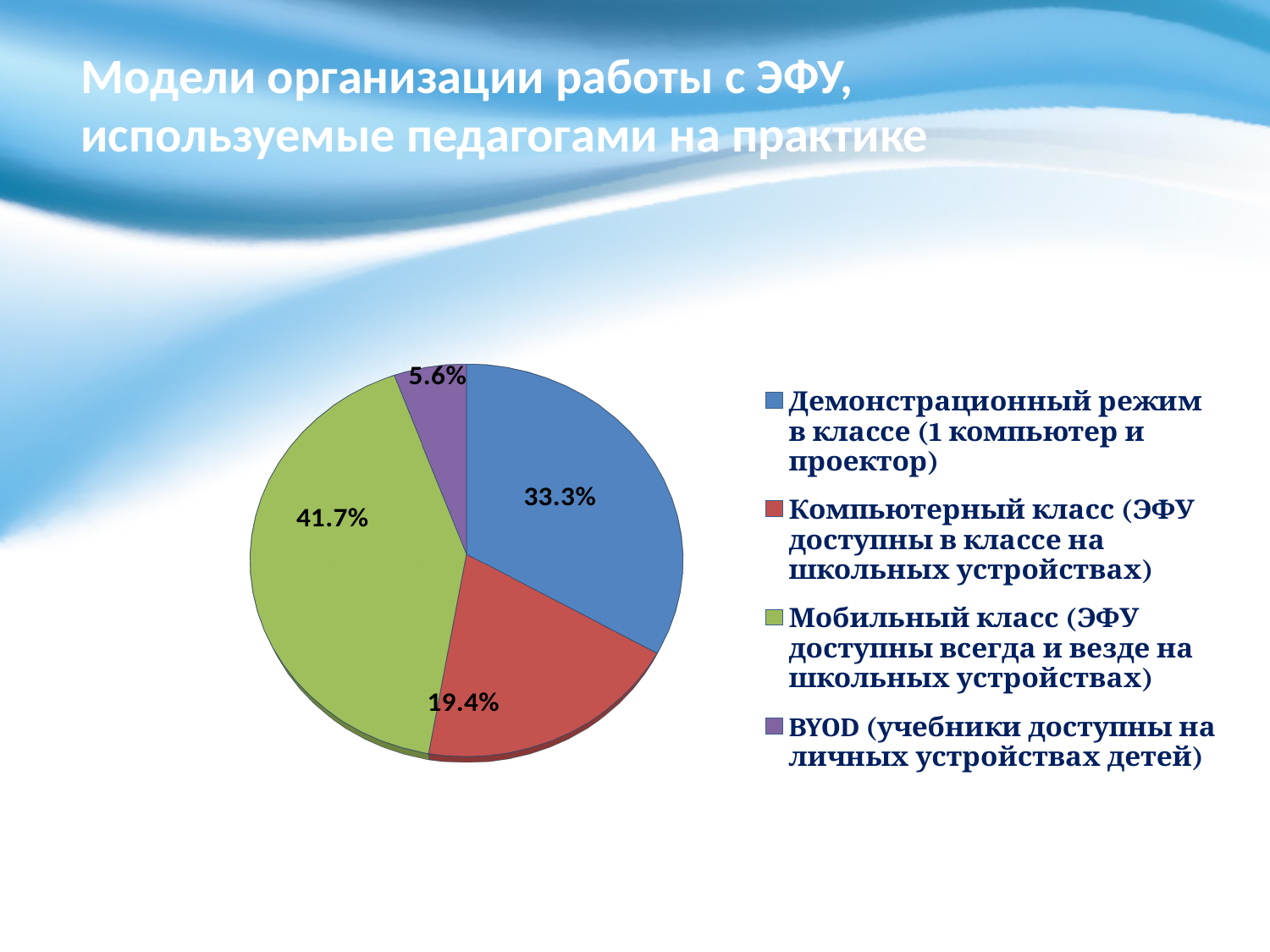
Which category has the smallest slice of the pie? BYOD (учебники доступны на личных устройствах детей) What is the value for "Демонстрационный режим в классе (1 компьютер и проектор)"? 33.3% What is the difference between the shares of "Мобильный класс" and "Демонстрационный режим в классе"? 8.4% What is the value for "Компьютерный класс (ЭФУ доступны в классе на школьных устройствах)"? 19.4% What kind of chart is shown on the slide? pie chart What share of the pie does "Мобильный класс (ЭФУ доступны всегда и везде на школьных устройствах)" have? 41.7% Which is larger: the share for "Демонстрационный режим в классе" or for "Компьютерный класс"? Демонстрационный режим в классе (1 компьютер и проектор) What colour is the slice for "Мобильный класс (ЭФУ доступны всегда и везде на школьных устройствах)"? green What is the difference between the shares of "Компьютерный класс" and "BYOD"? 13.8% How many categories does the pie chart have? 4 What is the value for "BYOD (учебники доступны на личных устройствах детей)"? 5.6% Which category has the largest slice of the pie? Мобильный класс (ЭФУ доступны всегда и везде на школьных устройствах)